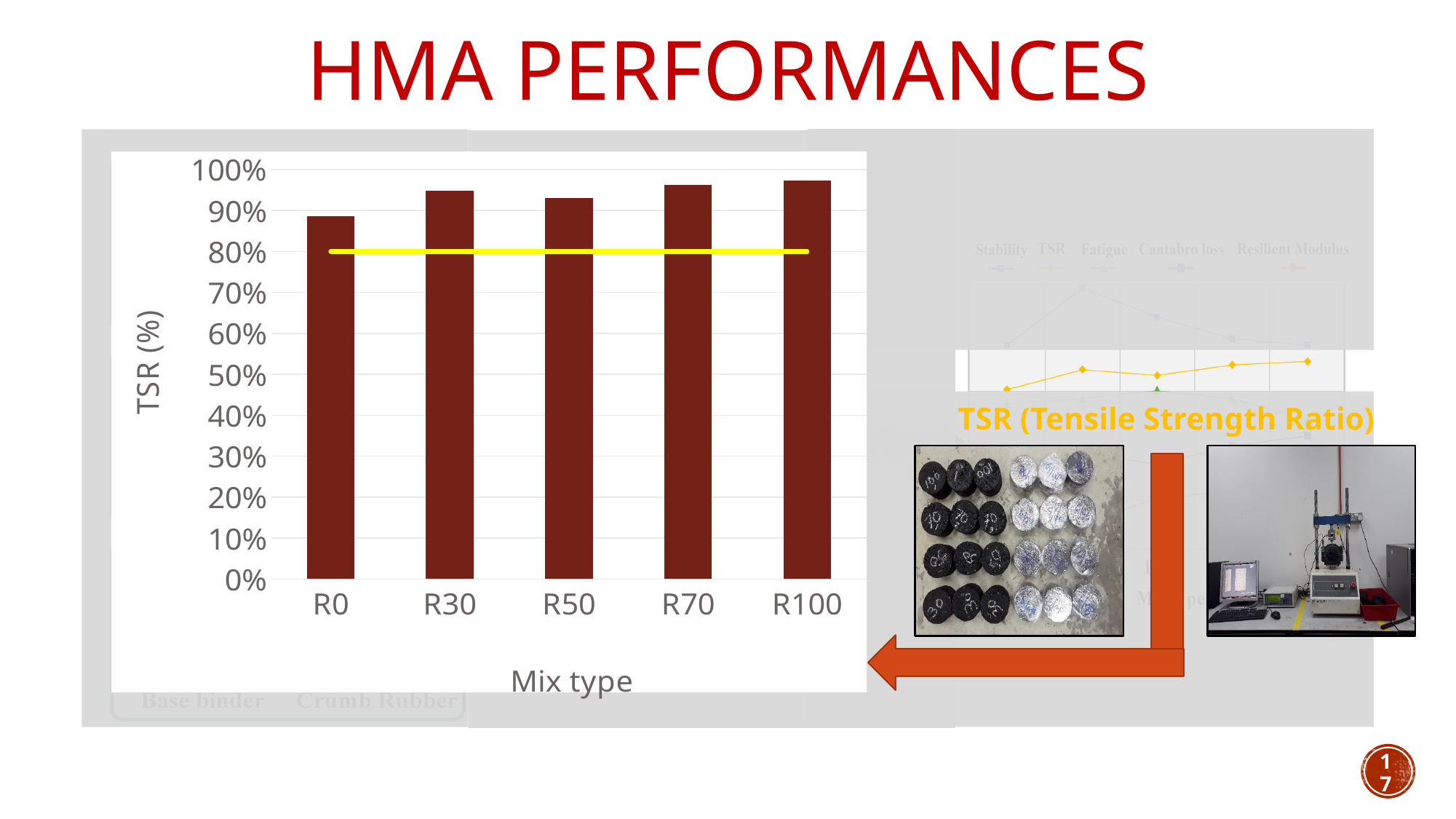
Is the TSR value for R100 greater or less than 90%? greater How many mix types are plotted on the x axis of the chart? 5 What is the label of the x axis of the chart? Mix type Which has a higher TSR value, R0 or R30? R30 Which mix type has the lowest TSR value in the chart? R0 Is the TSR value for R0 greater or less than 90%? less Which has a higher TSR value, R50 or R100? R100 What kind of chart is shown on the slide? bar chart Do all five bars in the chart exceed the yellow horizontal line? Yes Is the TSR value for R0 greater or less than 80%? greater What is the label of the y axis of the chart? TSR (%)